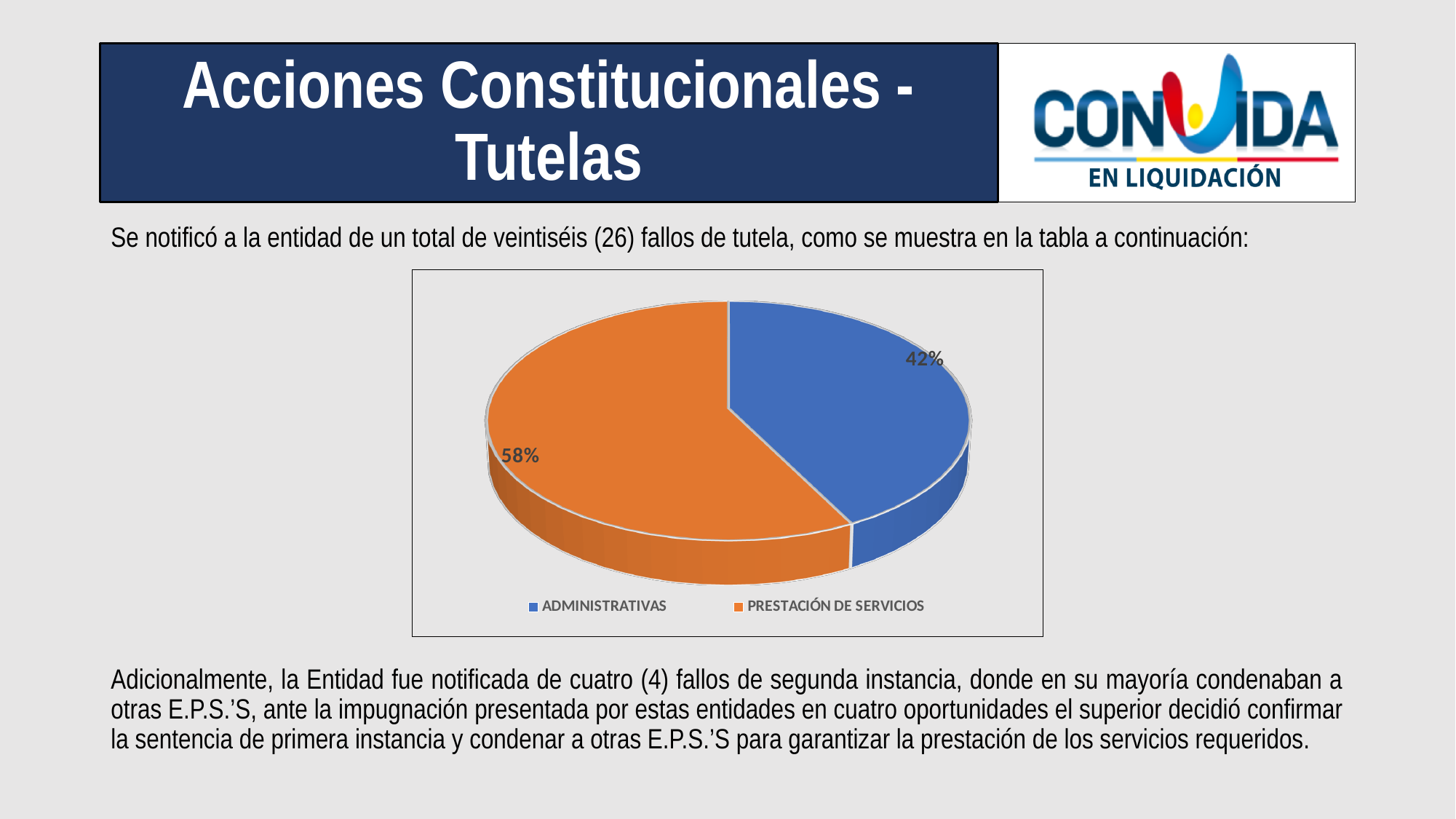
What share of the pie does PRESTACIÓN DE SERVICIOS represent? 58% How many entries does the legend list? 2 Which category has the largest slice of the pie? PRESTACIÓN DE SERVICIOS What share of the pie does ADMINISTRATIVAS represent? 42% What colour is the ADMINISTRATIVAS slice? blue How many categories does the pie chart show? 2 Which category has the smallest slice of the pie? ADMINISTRATIVAS What is the difference in percentage points between the PRESTACIÓN DE SERVICIOS slice and the ADMINISTRATIVAS slice? 16 percentage points What colour is the PRESTACIÓN DE SERVICIOS slice? orange What kind of chart is shown on the slide? pie chart Which is larger, the share for ADMINISTRATIVAS or the share for PRESTACIÓN DE SERVICIOS? PRESTACIÓN DE SERVICIOS